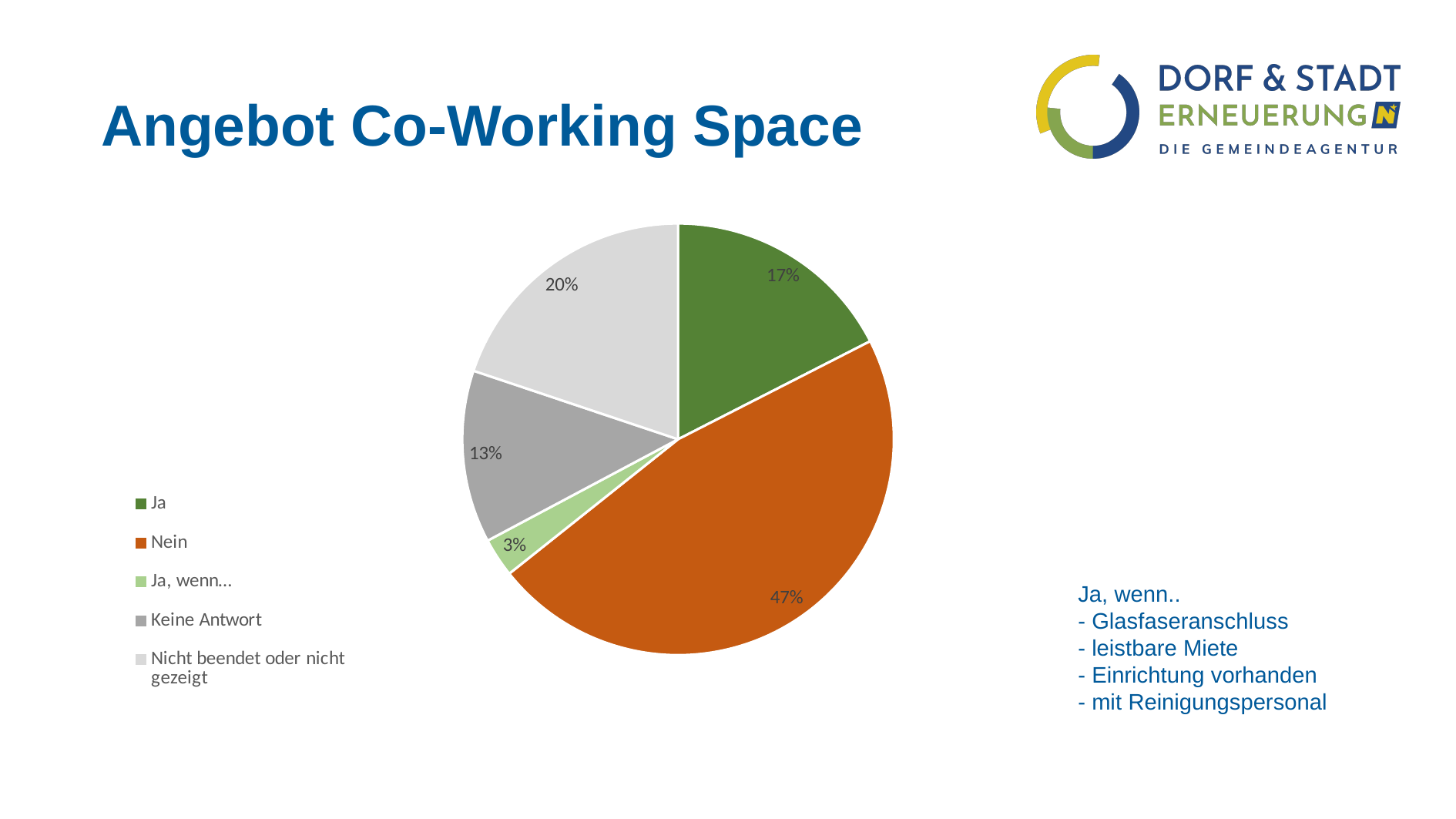
What percentage of the pie is labelled "Ja"? 17% Which category has the largest share of the pie? Nein What percentage of the pie is labelled "Keine Antwort"? 13% What is the difference in percentage points between "Nein" and "Ja"? 30 What percentage of the pie is labelled "Nein"? 47% What percentage of the pie is labelled "Ja, wenn..."? 3% What colour is the slice for "Nein"? orange Which category has the smallest share of the pie? Ja, wenn... What percentage of the pie is labelled "Nicht beendet oder nicht gezeigt"? 20% How many categories does the legend list? 5 What type of chart is shown on the slide? pie chart Which is larger, the share for "Nicht beendet oder nicht gezeigt" or the share for "Keine Antwort"? Nicht beendet oder nicht gezeigt